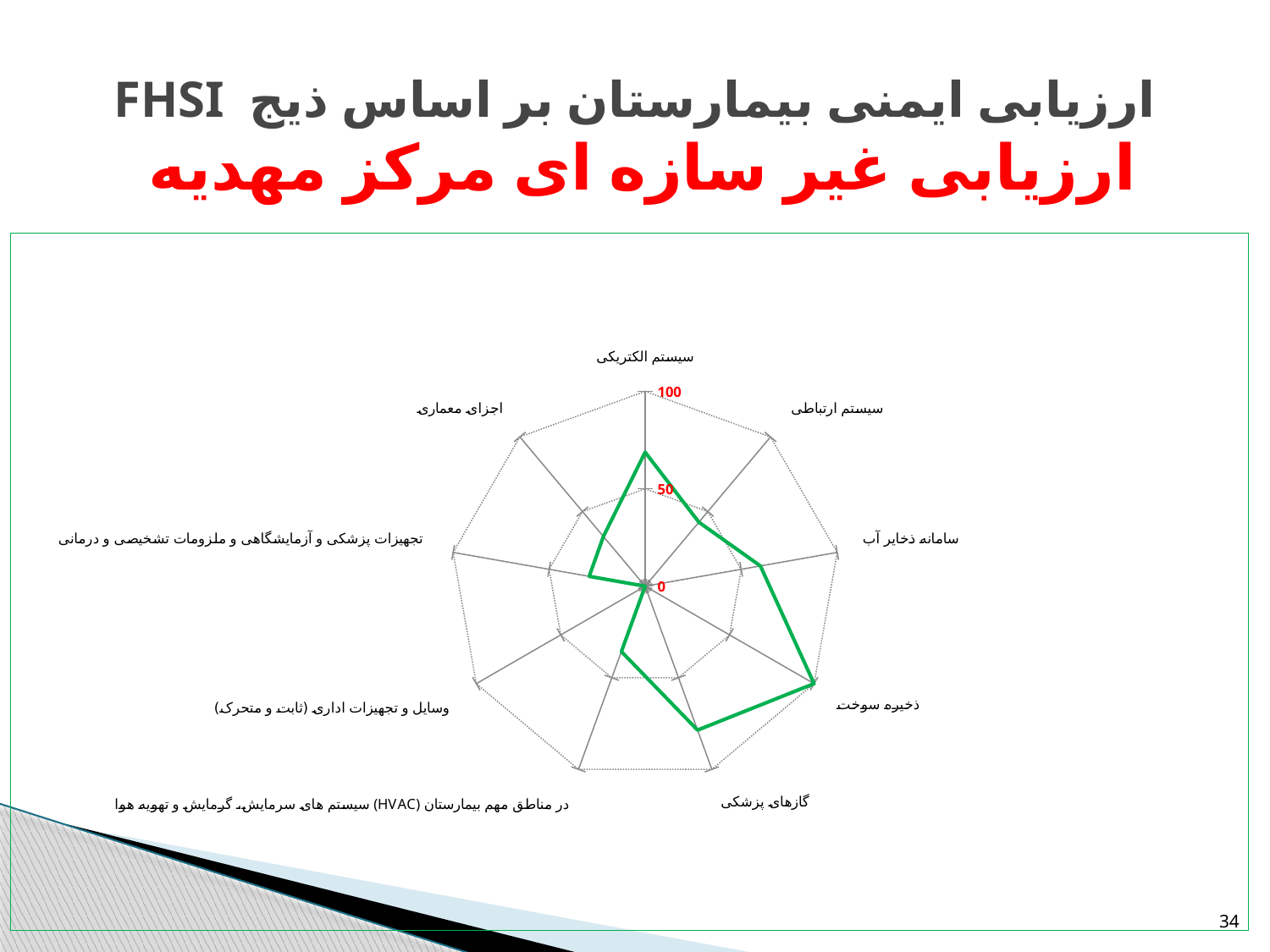
Which category has the lowest value in the radar chart? وسایل و تجهیزات اداری (ثابت و متحرک) Is the value for سیستم الکتریکی greater or less than 50? greater Is the value for ذخیره سوخت greater or less than 50? greater How many categories (axes) does the radar chart have? 9 Which category has the highest value in the radar chart? ذخیره سوخت Which is larger, the value for سیستم الکتریکی or the value for تجهیزات پزشکی و آزمایشگاهی و ملزومات تشخیصی و درمانی? سیستم الکتریکی What kind of chart is shown on the slide? Radar chart What is the maximum value shown on the radar chart's axis scale? 100 Which is larger, the value for ذخیره سوخت or the value for سیستم های سرمایش، گرمایش و تهویه هوا (HVAC)? ذخیره سوخت Is the value for تجهیزات پزشکی و آزمایشگاهی و ملزومات تشخیصی و درمانی greater or less than 50? less